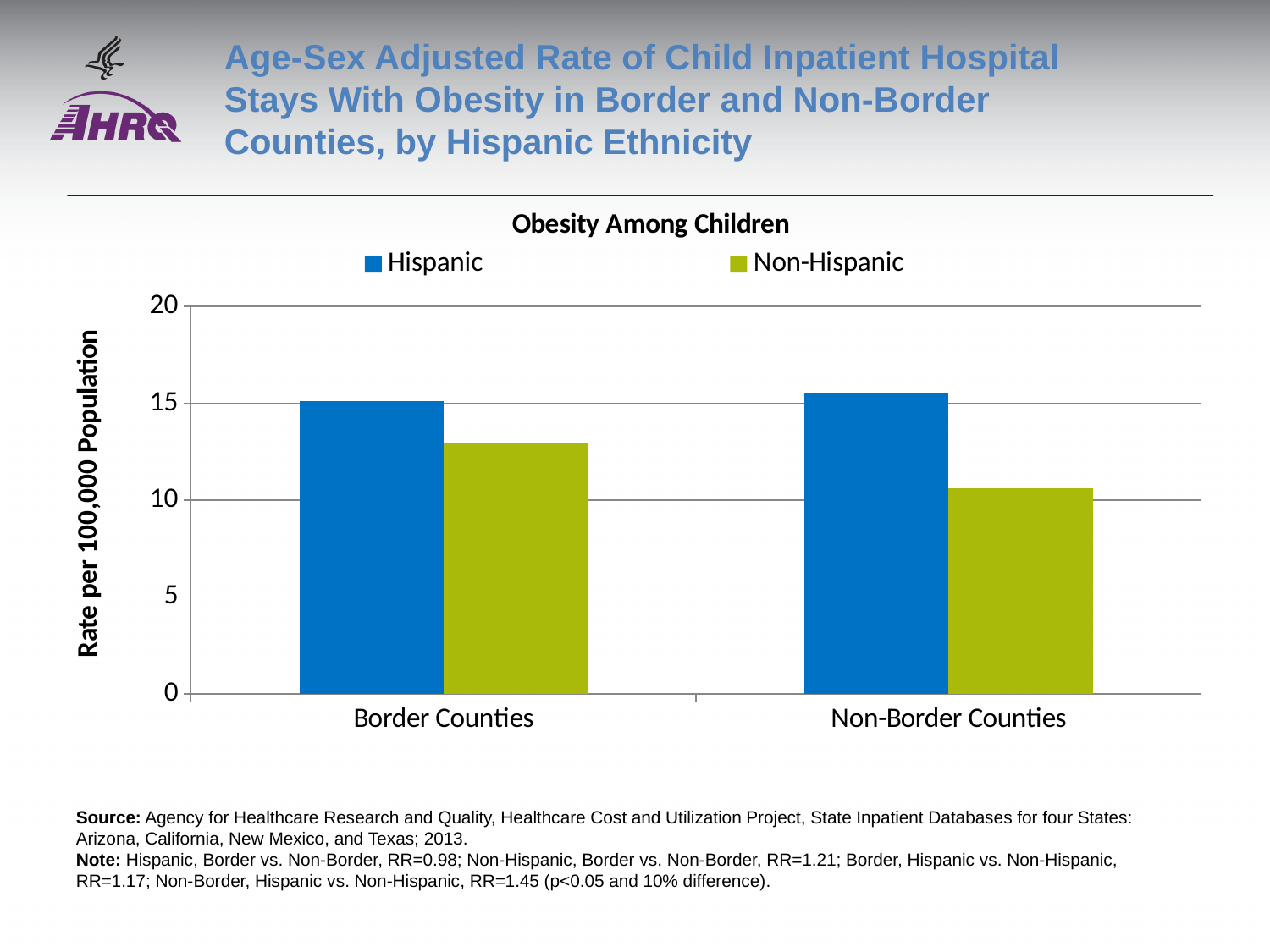
What is the title of the chart? Obesity Among Children Is the Non-Hispanic value for Border Counties greater or less than 10? greater In Border Counties, which is larger: the Hispanic rate or the Non-Hispanic rate? Hispanic Is the Hispanic value for Border Counties greater or less than 10? greater In Non-Border Counties, which is larger: the Hispanic rate or the Non-Hispanic rate? Hispanic How many series does the legend list? 2 How many county categories are shown on the x axis? 2 Which is larger: the Non-Hispanic rate in Border Counties or the Non-Hispanic rate in Non-Border Counties? Border Counties Is the Non-Hispanic value for Border Counties greater or less than 15? less Which bar is the lowest in the chart? Non-Hispanic in Non-Border Counties What kind of chart is shown on the slide? bar chart What is the label of the y axis? Rate per 100,000 Population